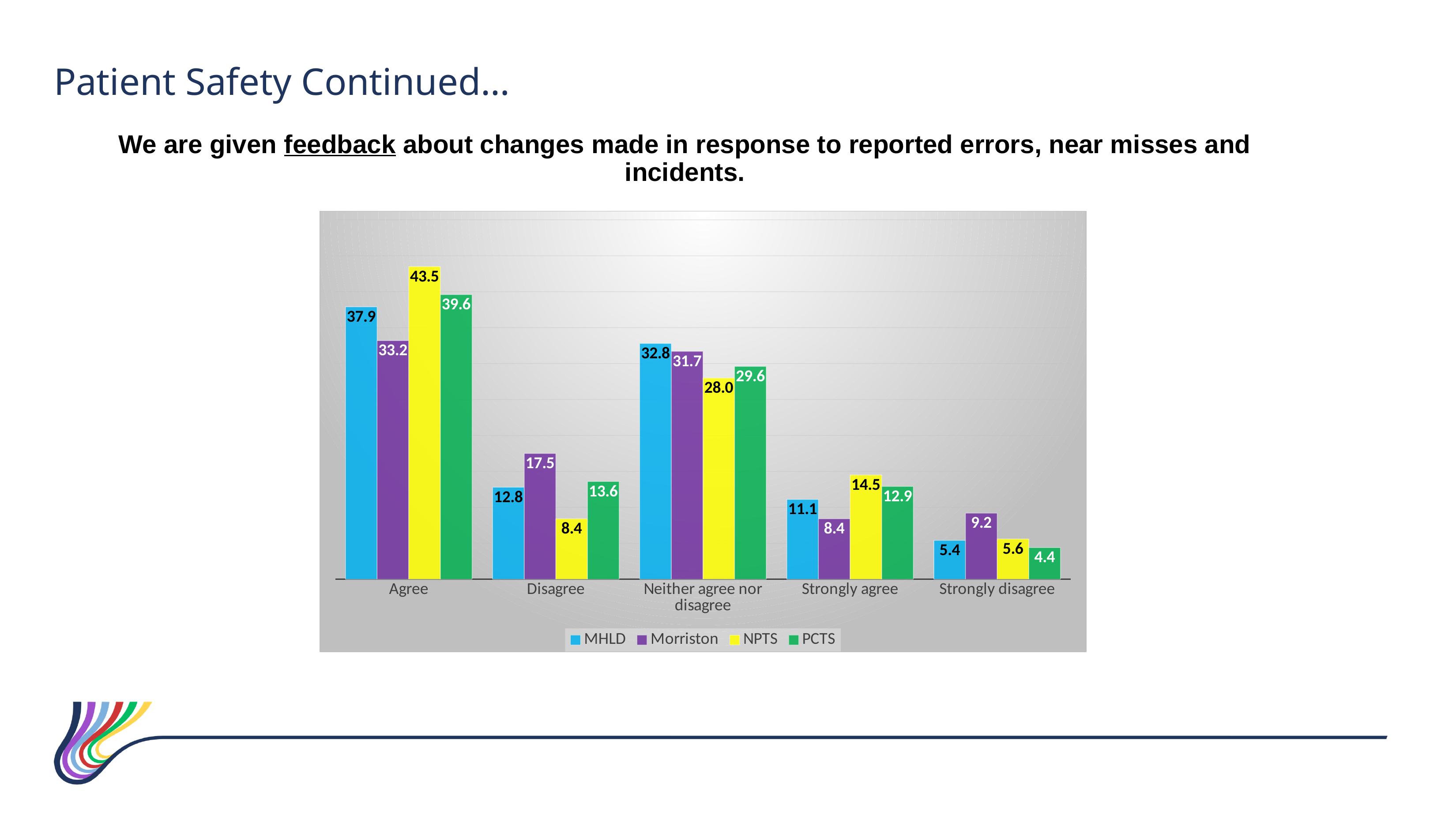
What is the value for NPTS in the Agree category? 43.5 Which series has the lowest value in the Strongly agree category? Morriston Which is larger in the Disagree category, the MHLD value or the PCTS value? PCTS How many series does the legend list? 4 How many categories are shown on the x axis? 5 What is the difference between the NPTS and MHLD values in the Agree category? 5.6 Which colour represents NPTS in the chart? Yellow What kind of chart is shown on the slide? Bar chart What is the value for MHLD in the Neither agree nor disagree category? 32.8 Which series has the highest value in the Agree category? NPTS What is the value for Morriston in the Disagree category? 17.5 What is the value for PCTS in the Strongly disagree category? 4.4